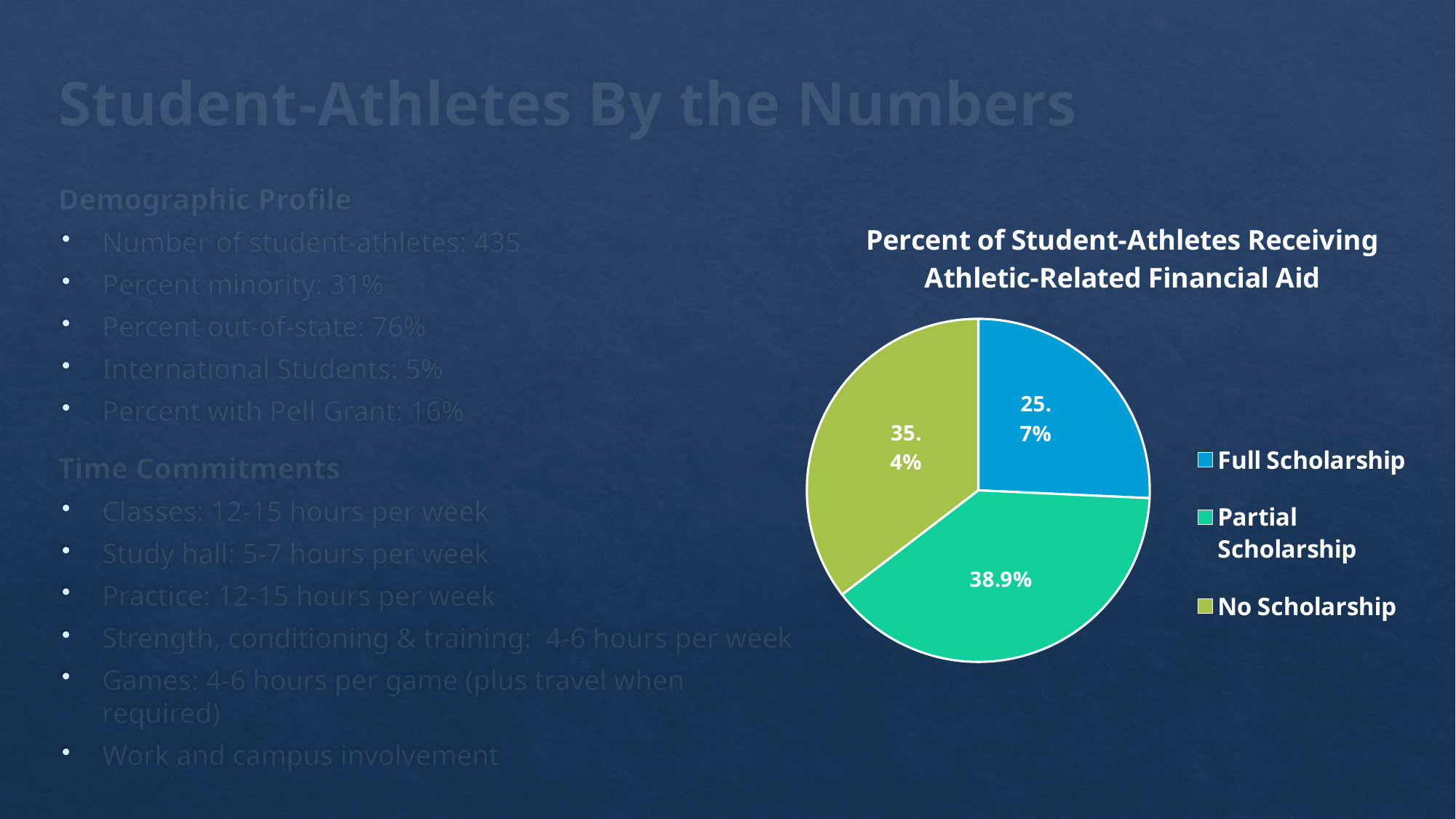
What percentage of student-athletes receive a Full Scholarship? 25.7% Which colour represents the Full Scholarship slice? blue Which category has the largest share of the pie? Partial Scholarship Which is larger, the share for No Scholarship or the share for Full Scholarship? No Scholarship Which category has the smallest share of the pie? Full Scholarship What is the title of the chart? Percent of Student-Athletes Receiving Athletic-Related Financial Aid What is the difference in percentage points between Partial Scholarship and Full Scholarship? 13.2 What kind of chart is shown on the slide? pie chart How many categories does the pie chart show? 3 What is the difference in percentage points between Partial Scholarship and No Scholarship? 3.5 What percentage of student-athletes receive a Partial Scholarship? 38.9% What percentage of student-athletes receive No Scholarship? 35.4%